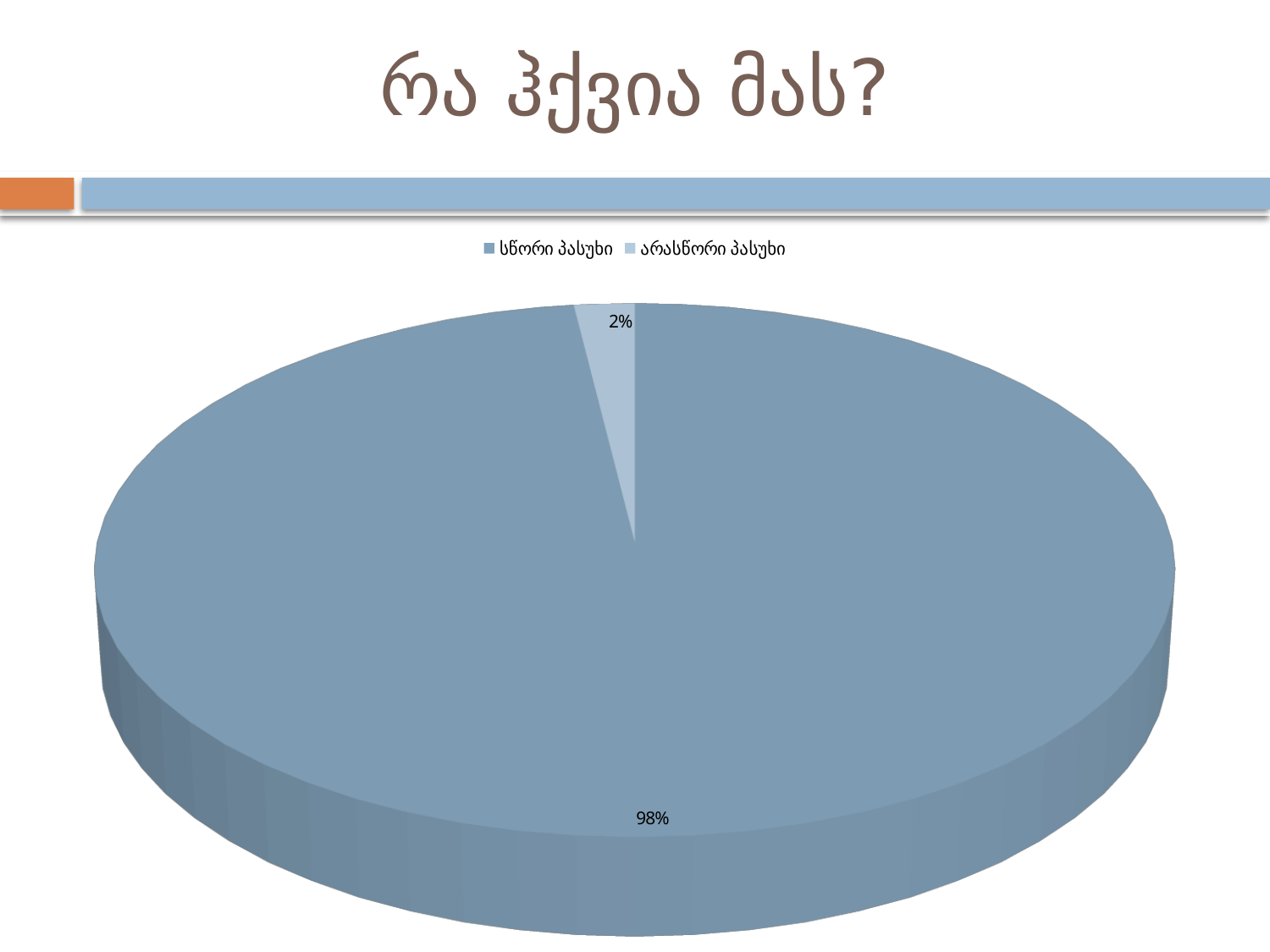
What share of the pie does არასწორი პასუხი take? 2% Which slice of the pie is the smallest? არასწორი პასუხი How many entries does the legend list? 2 What is the label of the first legend entry? სწორი პასუხი How many slices does the pie chart have? 2 Which is larger, the სწორი პასუხი slice or the არასწორი პასუხი slice? სწორი პასუხი What is the difference in percentage points between the სწორი პასუხი slice and the არასწორი პასუხი slice? 96 What share of the pie does სწორი პასუხი take? 98% What kind of chart is shown on the slide? pie chart What is the title of the slide containing the pie chart? რა ჰქვია მას? Which slice of the pie is the largest? სწორი პასუხი